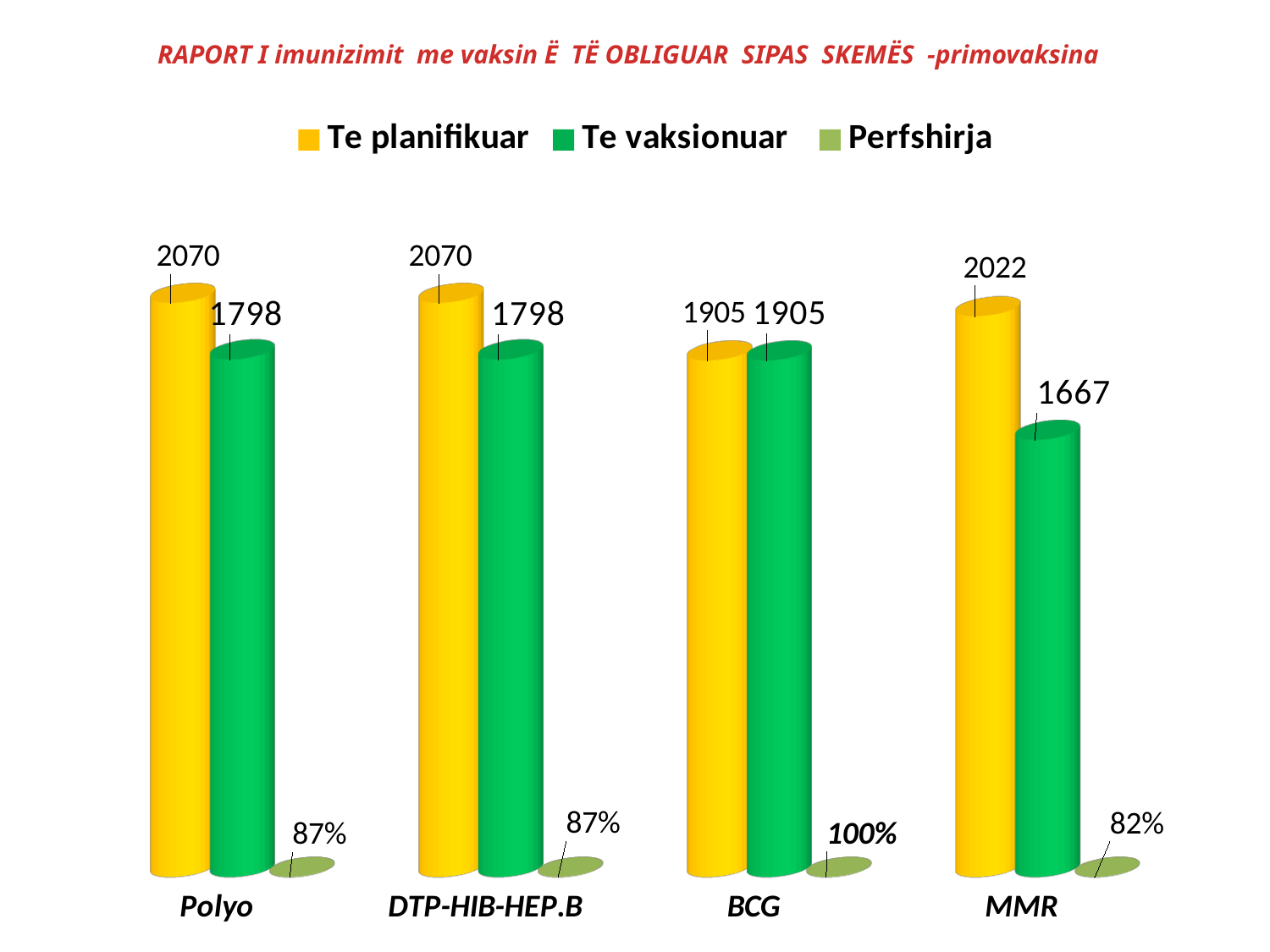
Which category has the lowest 'Te vaksionuar' value? MMR Which category has the lowest 'Perfshirja' value? MMR Which is larger, the 'Te vaksionuar' value for BCG or for MMR? BCG What is the difference between 'Te planifikuar' and 'Te vaksionuar' for Polyo? 272 How many categories are shown on the x axis? 4 What is the 'Perfshirja' value for BCG? 100% What is the difference between 'Te planifikuar' and 'Te vaksionuar' for MMR? 355 How many series does the legend list? 3 What is the 'Te vaksionuar' value for MMR? 1667 What kind of chart is shown on the slide? Bar chart What is the 'Te vaksionuar' value for DTP-HIB-HEP.B? 1798 What is the 'Te planifikuar' value for Polyo? 2070